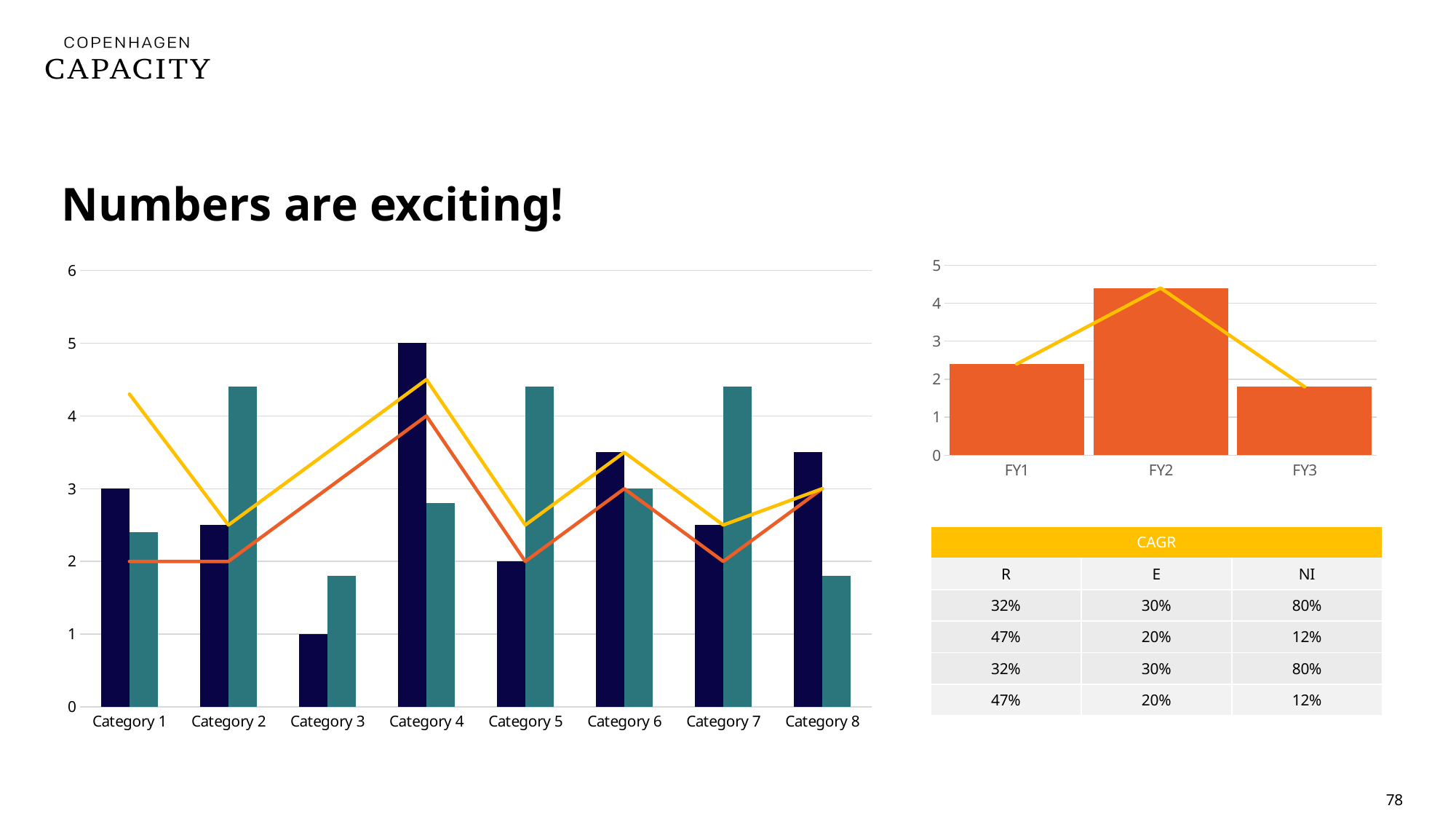
On the right chart, is the value for FY2 greater or less than 4? greater On the left chart, what is the value of the dark navy bar for Category 3? 1 On the left chart, which category has the tallest dark navy bar? Category 4 On the right chart, which fiscal year has the tallest bar? FY2 On the left chart, which category has the shortest dark navy bar? Category 3 On the right chart, do the bar values rise or fall from FY2 to FY3? fall On the left chart, what is the value of the dark navy bar for Category 4? 5 On the left chart, for Category 2, which bar is taller: the dark navy bar or the teal bar? the teal bar On the left chart, what is the difference between the dark navy bars for Category 4 and Category 3? 4 How many categories are shown on the x axis of the left chart? 8 On the left chart, what is the value of the dark navy bar for Category 1? 3 On the right chart, is the value for FY3 greater or less than 2? less